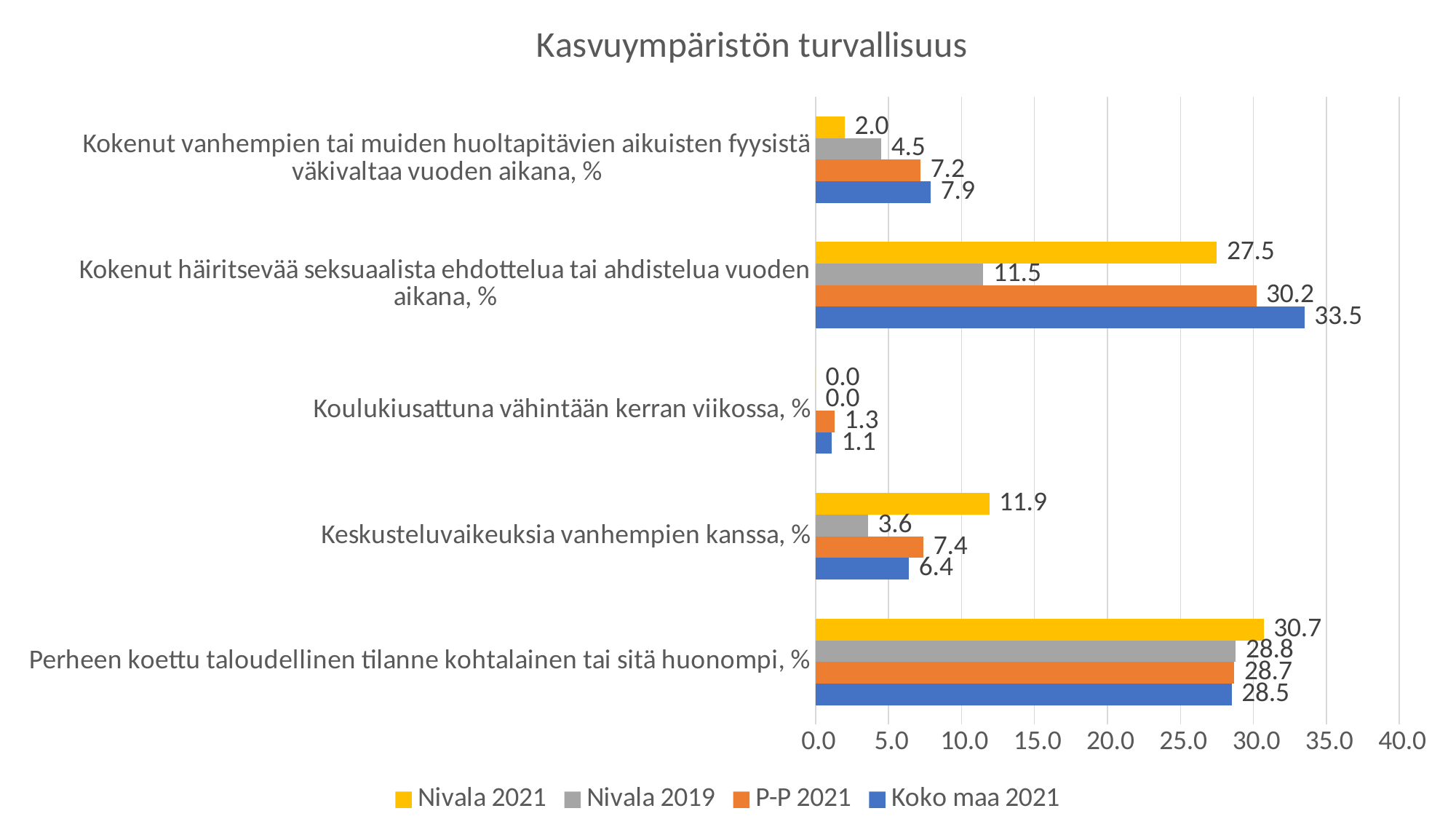
In the category "Kokenut vanhempien tai muiden huoltapitävien aikuisten fyysistä väkivaltaa vuoden aikana, %", which is larger: the P-P 2021 value or the Koko maa 2021 value? Koko maa 2021 What type of chart is shown on the slide? Bar chart How many series does the legend list? 4 How many categories are shown on the chart? 5 What is the value for Nivala 2021 in the category "Keskusteluvaikeuksia vanhempien kanssa, %"? 11.9 What is the value for Nivala 2019 in the category "Kokenut vanhempien tai muiden huoltapitävien aikuisten fyysistä väkivaltaa vuoden aikana, %"? 4.5 Is the Nivala 2021 value for "Kokenut häiritsevää seksuaalista ehdottelua tai ahdistelua vuoden aikana, %" greater or less than 25.0? greater What is the difference between the Koko maa 2021 and Nivala 2019 values in the category "Kokenut häiritsevää seksuaalista ehdottelua tai ahdistelua vuoden aikana, %"? 22.0 Which series has the lowest value in the category "Keskusteluvaikeuksia vanhempien kanssa, %"? Nivala 2019 What is the value for P-P 2021 in the category "Koulukiusattuna vähintään kerran viikossa, %"? 1.3 Which series has the highest value in the category "Perheen koettu taloudellinen tilanne kohtalainen tai sitä huonompi, %"? Nivala 2021 What is the value for Koko maa 2021 in the category "Kokenut häiritsevää seksuaalista ehdottelua tai ahdistelua vuoden aikana, %"? 33.5